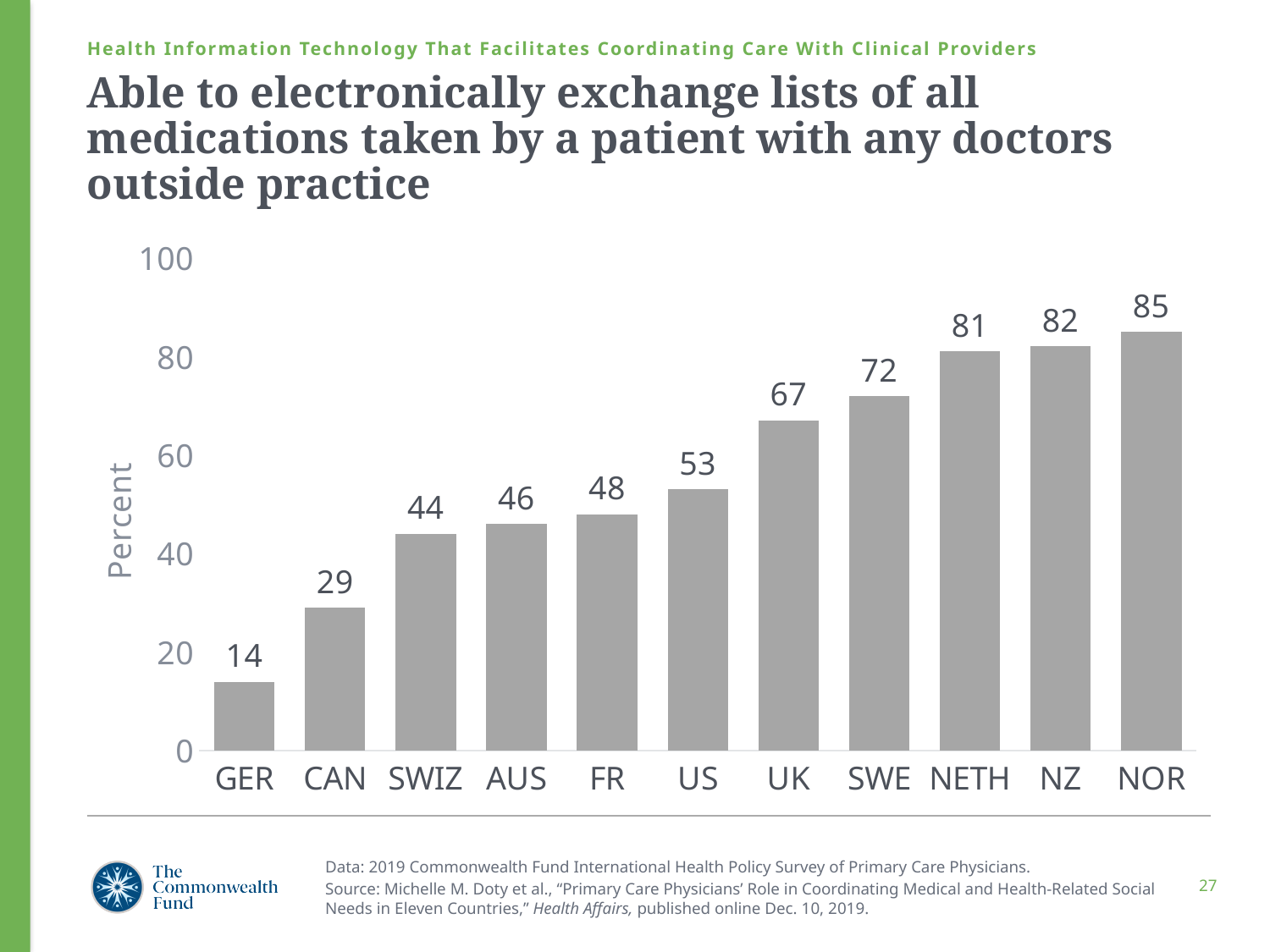
What is the value for US? 53 Which country has the highest value? NOR What is the value for SWE? 72 How many countries are shown on the chart? 11 Do the values rise or fall from left to right along the x axis? rise What is the value for GER? 14 What is the difference between the values for NOR and GER? 71 What kind of chart is shown on the slide? bar chart Which is larger, the value for CAN or the value for AUS? AUS Which country has the lowest value? GER What is the difference between the values for UK and FR? 19 Is the value for NETH greater or less than 80? greater